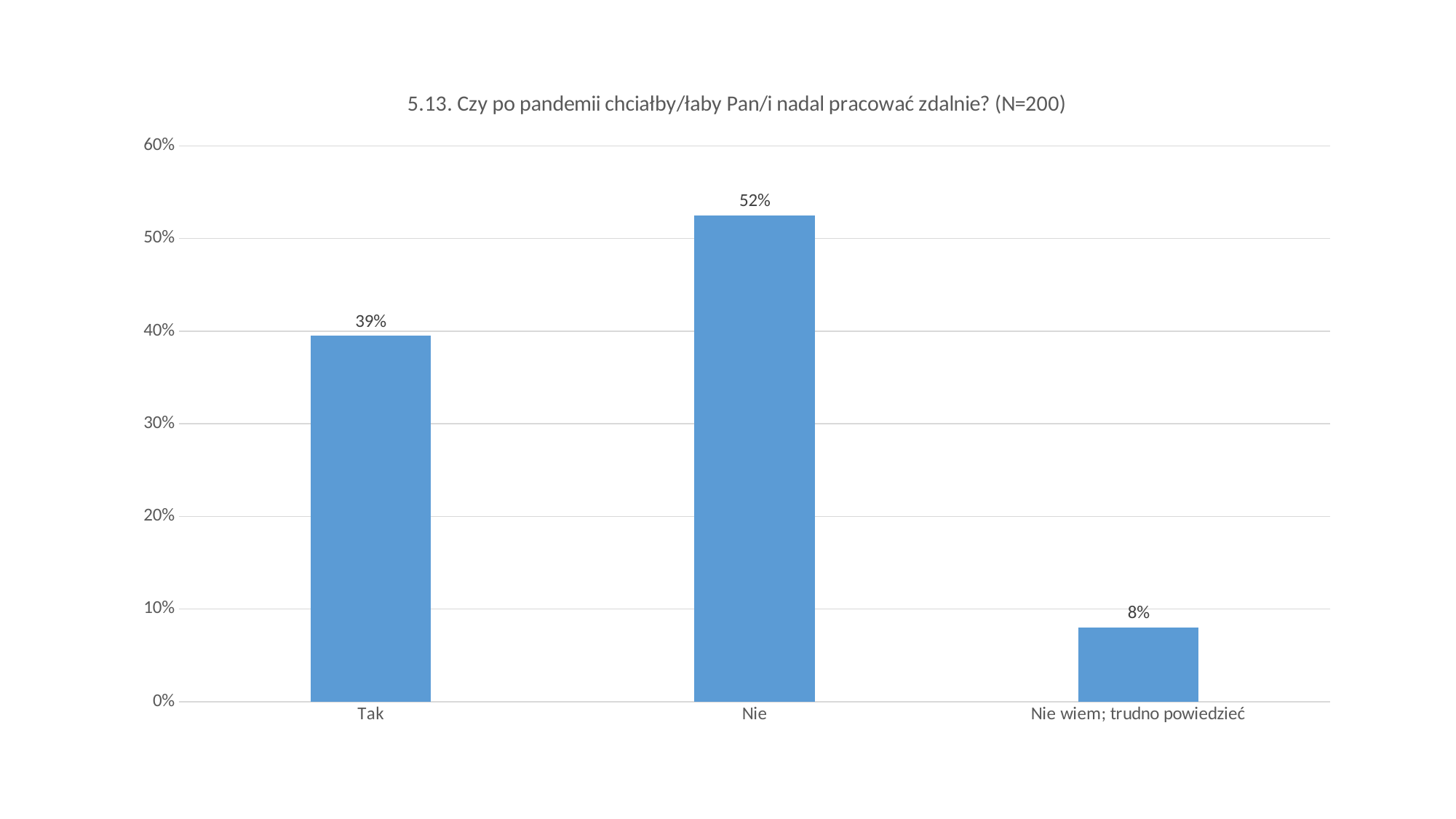
Which category has the highest value? Nie What is the difference between the values for "Nie" and "Tak"? 13% Which is larger, the value for "Tak" or the value for "Nie"? Nie Is the value for "Nie" greater or less than 50%? greater Which category has the lowest value? Nie wiem; trudno powiedzieć What is the value for "Tak"? 39% What is the difference between the values for "Tak" and "Nie wiem; trudno powiedzieć"? 31% What is the value for "Nie"? 52% What is the value for "Nie wiem; trudno powiedzieć"? 8% What is the title of the chart? 5.13. Czy po pandemii chciałby/łaby Pan/i nadal pracować zdalnie? (N=200) How many categories are shown on the x axis? 3 What kind of chart is shown on the slide? bar chart